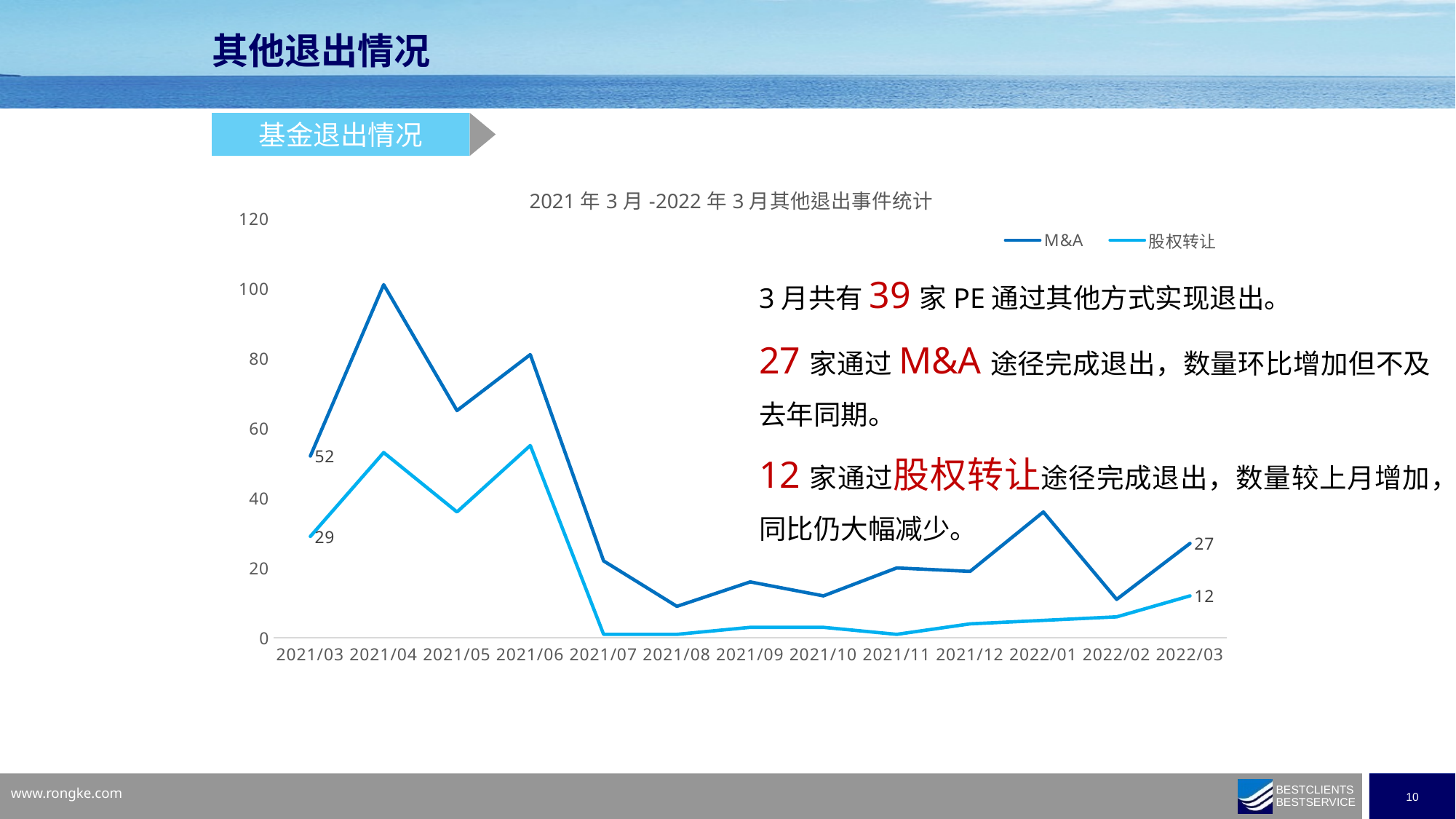
What is the value for 股权转让 in 2022/03? 12 What is the difference between the M&A value and the 股权转让 value in 2022/03? 15 What is the difference between the M&A value in 2021/03 and the M&A value in 2022/03? 25 What is the value for M&A in 2022/03? 27 What is the value for M&A in 2021/03? 52 What is the value for 股权转让 in 2021/03? 29 What kind of chart is shown on the slide? Line chart Is the value for 股权转让 in 2021/07 greater or less than 20? less In which month does the M&A series reach its highest value? 2021/04 Which series has the larger value in 2021/06, M&A or 股权转让? M&A How many series does the legend list? 2